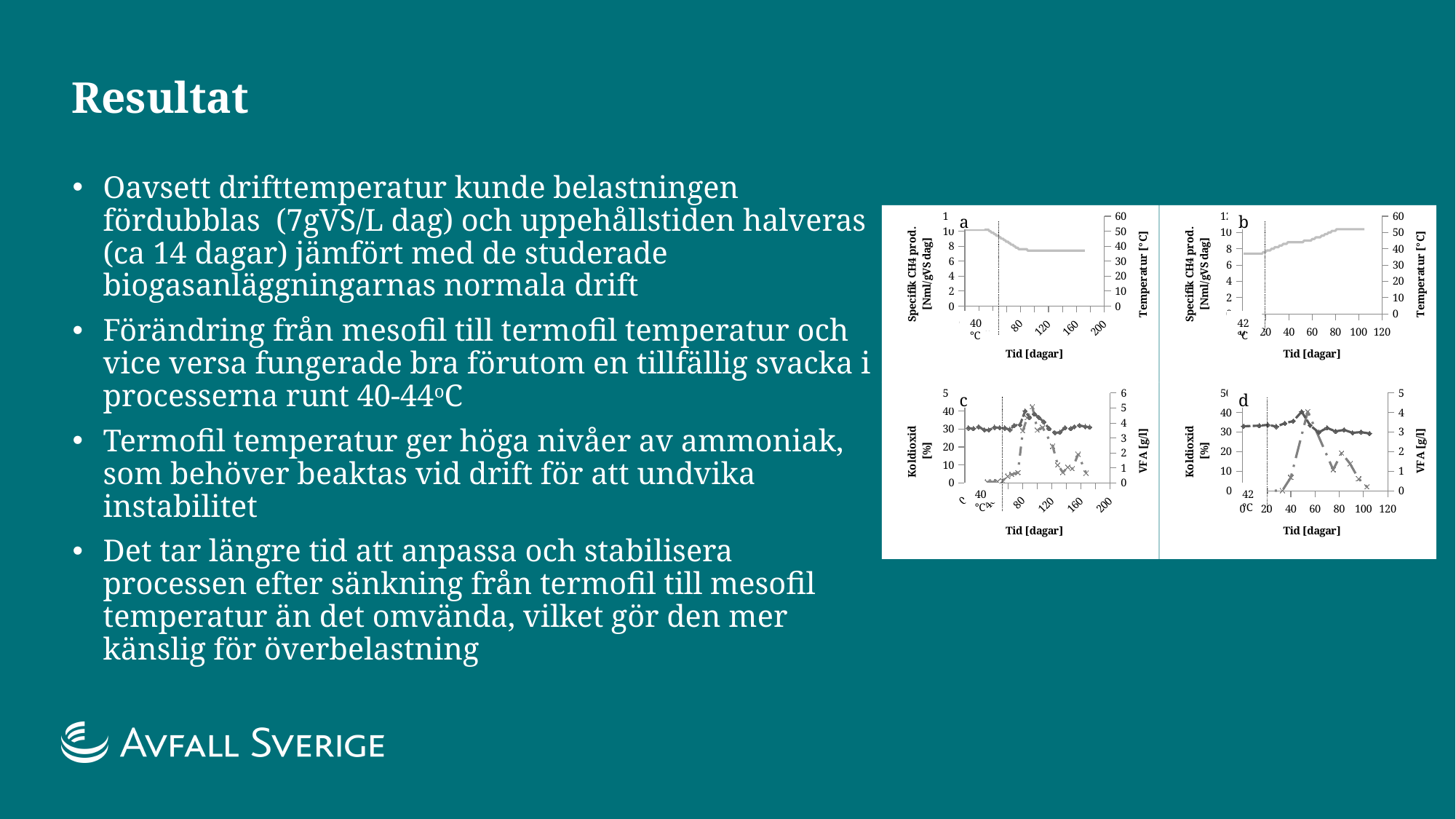
In chart b (top right), is the temperature at day 100 greater or less than 40? greater In chart b (top right), does the temperature line rise or fall along the x axis? rise In chart c (bottom left), is the Koldioxid value at day 40 greater or less than 40? less What is the x-axis label of chart c (bottom left)? Tid [dagar] In chart a (top left), is the temperature at day 160 greater or less than 50? less How many charts are shown on the slide? 4 What kind of chart is chart a (top left)? line chart In chart a (top left), does the temperature line rise or fall along the x axis? fall What is the left y-axis label of chart d (bottom right)? Koldioxid [%]